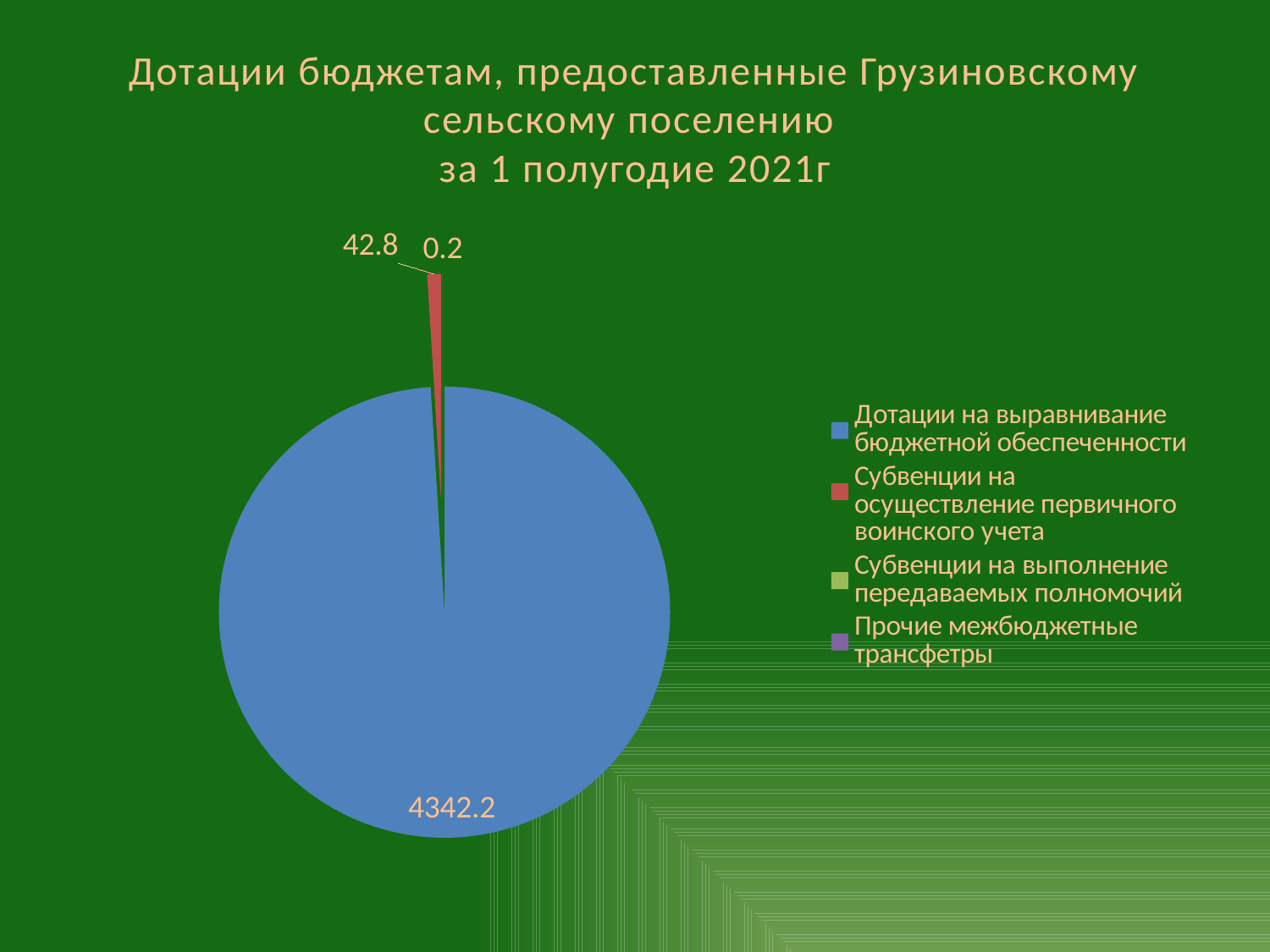
Which is larger: the value for Субвенции на осуществление первичного воинского учета or the value for Субвенции на выполнение передаваемых полномочий? Субвенции на осуществление первичного воинского учета Is the value for Дотации на выравнивание бюджетной обеспеченности greater or less than 4000? greater What is the difference between the value for Субвенции на осуществление первичного воинского учета and the value for Субвенции на выполнение передаваемых полномочий? 42.6 What is the difference between the value for Дотации на выравнивание бюджетной обеспеченности and the value for Субвенции на осуществление первичного воинского учета? 4299.4 Which category has the largest slice of the pie? Дотации на выравнивание бюджетной обеспеченности What value is shown for Субвенции на выполнение передаваемых полномочий? 0.2 What value is shown for Дотации на выравнивание бюджетной обеспеченности? 4342.2 What kind of chart is shown on the slide? Pie chart What value is shown for Субвенции на осуществление первичного воинского учета? 42.8 What colour is the slice for Дотации на выравнивание бюджетной обеспеченности? Blue Which period does the chart title say the data covers? 1 полугодие 2021г How many entries does the legend list? 4